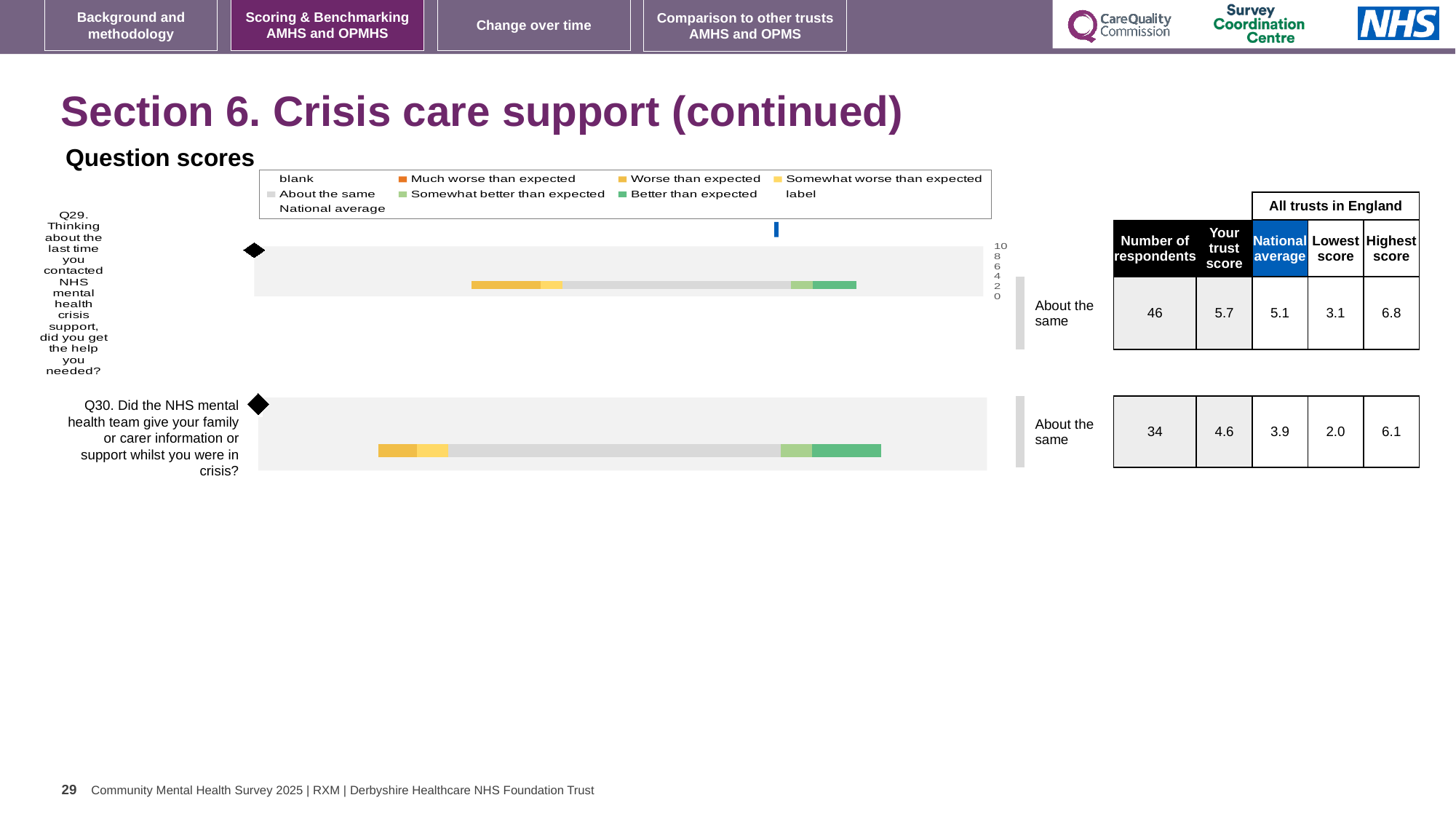
Which question has more respondents, Q29 or Q30? Q29 In the table beside the chart, what is the national average for Q30? 3.9 In the table beside the chart, what is the highest score for Q29 among all trusts in England? 6.8 Which colour in the legend represents 'Better than expected'? Green Which is larger for Q29: the trust score or the national average? Trust score How many questions (bars) are plotted in the question scores chart? 2 What benchmark category is shown next to the bar for Q30? About the same In the table beside the chart, what is the trust score for Q29? 5.7 What is the difference between the trust score and the national average for Q30? 0.7 What kind of chart is used to show the question scores for Q29 and Q30? Bar chart In the table beside the chart, how many respondents answered Q30? 34 What benchmark category is shown next to the bar for Q29? About the same